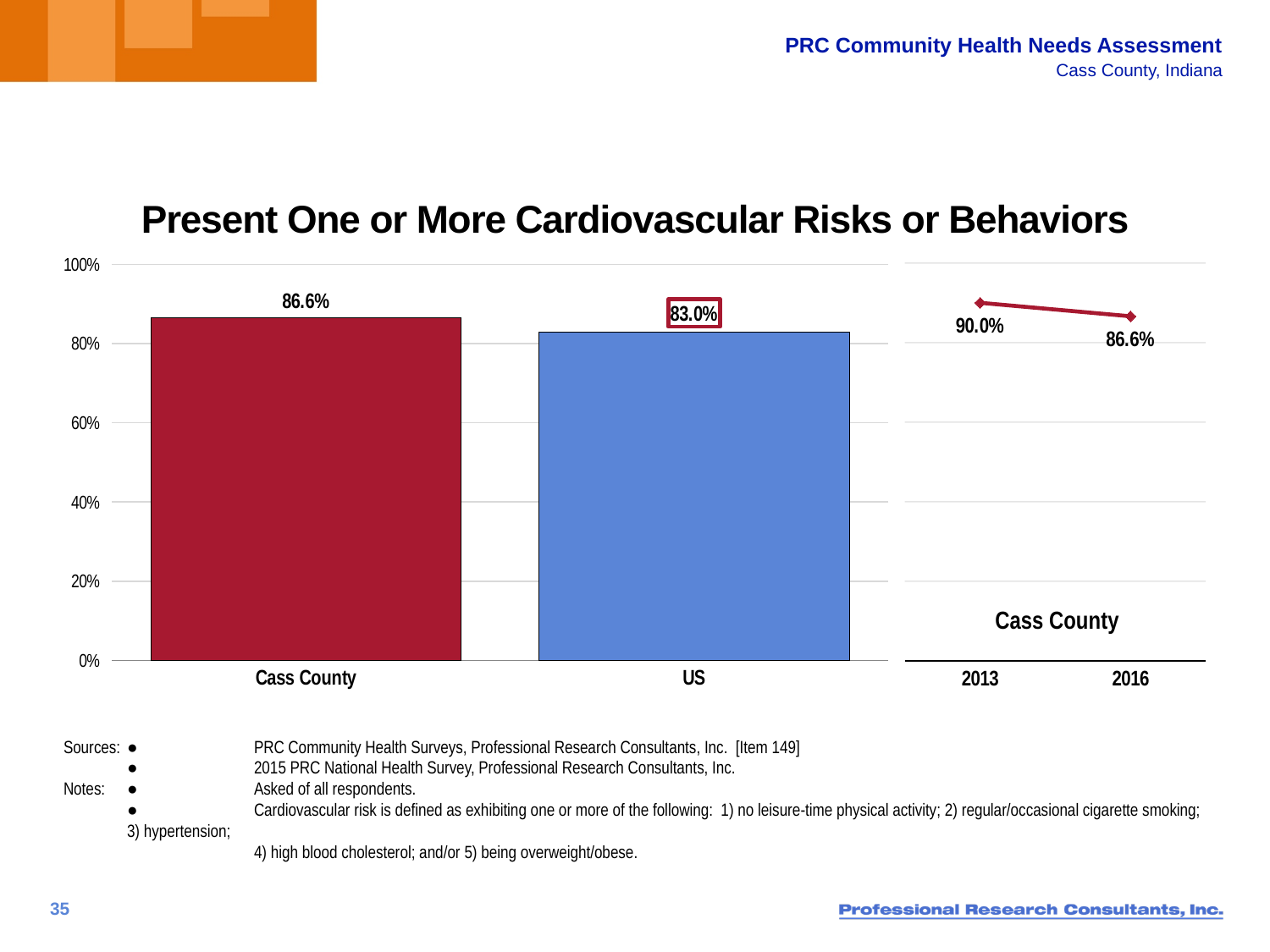
In the line chart on the right (Cass County trend), does the value rise or fall from 2013 to 2016? Fall In the bar chart on the left, what is the value for US? 83.0% What is the title of the chart on the slide? Present One or More Cardiovascular Risks or Behaviors In the line chart on the right (Cass County trend), what is the value for 2013? 90.0% In the bar chart on the left, how many bars are shown? 2 In the line chart on the right (Cass County trend), what is the difference between the 2013 and 2016 values? 3.4% In the bar chart on the left, is the value for US greater or less than 80%? greater In the bar chart on the left, what is the value for Cass County? 86.6% In the line chart on the right (Cass County trend), what is the value for 2016? 86.6% What kind of chart is shown on the left side of the slide? Bar chart In the bar chart on the left, what is the difference between the Cass County value and the US value? 3.6% In the bar chart on the left, which category has the higher value, Cass County or US? Cass County